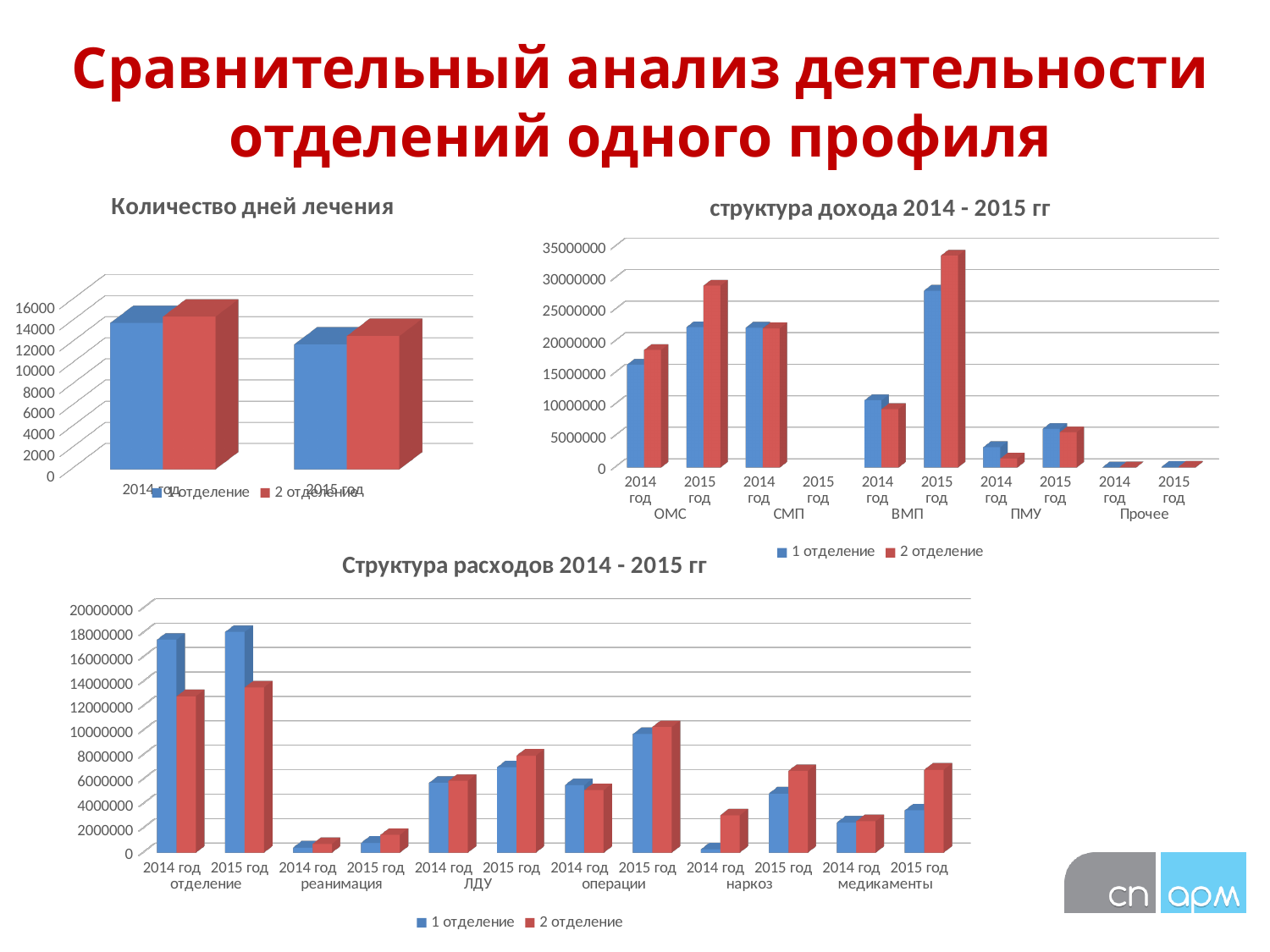
In the 'структура дохода 2014 - 2015 гг' chart, which bar is the highest? 2 отделение, ВМП 2015 год In the 'структура дохода 2014 - 2015 гг' chart, how many year categories are shown along the x axis? 10 In the 'структура дохода 2014 - 2015 гг' chart, which is larger for ОМС 2015 год: 1 отделение or 2 отделение? 2 отделение In the 'Количество дней лечения' chart, is the value for 1 отделение in 2014 год greater or less than 12000? greater In the 'Количество дней лечения' chart, how many series does the legend list? 2 What kind of chart is the 'Количество дней лечения' chart? bar chart In the 'Структура расходов 2014 - 2015 гг' chart, which is larger for медикаменты 2015 год: 1 отделение or 2 отделение? 2 отделение What is the title of the chart at the bottom of the slide? Структура расходов 2014 - 2015 гг In the 'Количество дней лечения' chart, do the values for 1 отделение rise or fall from 2014 год to 2015 год? fall In the 'структура дохода 2014 - 2015 гг' chart, is the value for 2 отделение in ОМС 2015 год greater or less than 25000000? greater In the 'Структура расходов 2014 - 2015 гг' chart, which bar is the highest? 1 отделение, отделение 2015 год In the 'Структура расходов 2014 - 2015 гг' chart, is the value for 1 отделение in наркоз 2014 год greater or less than 2000000? less